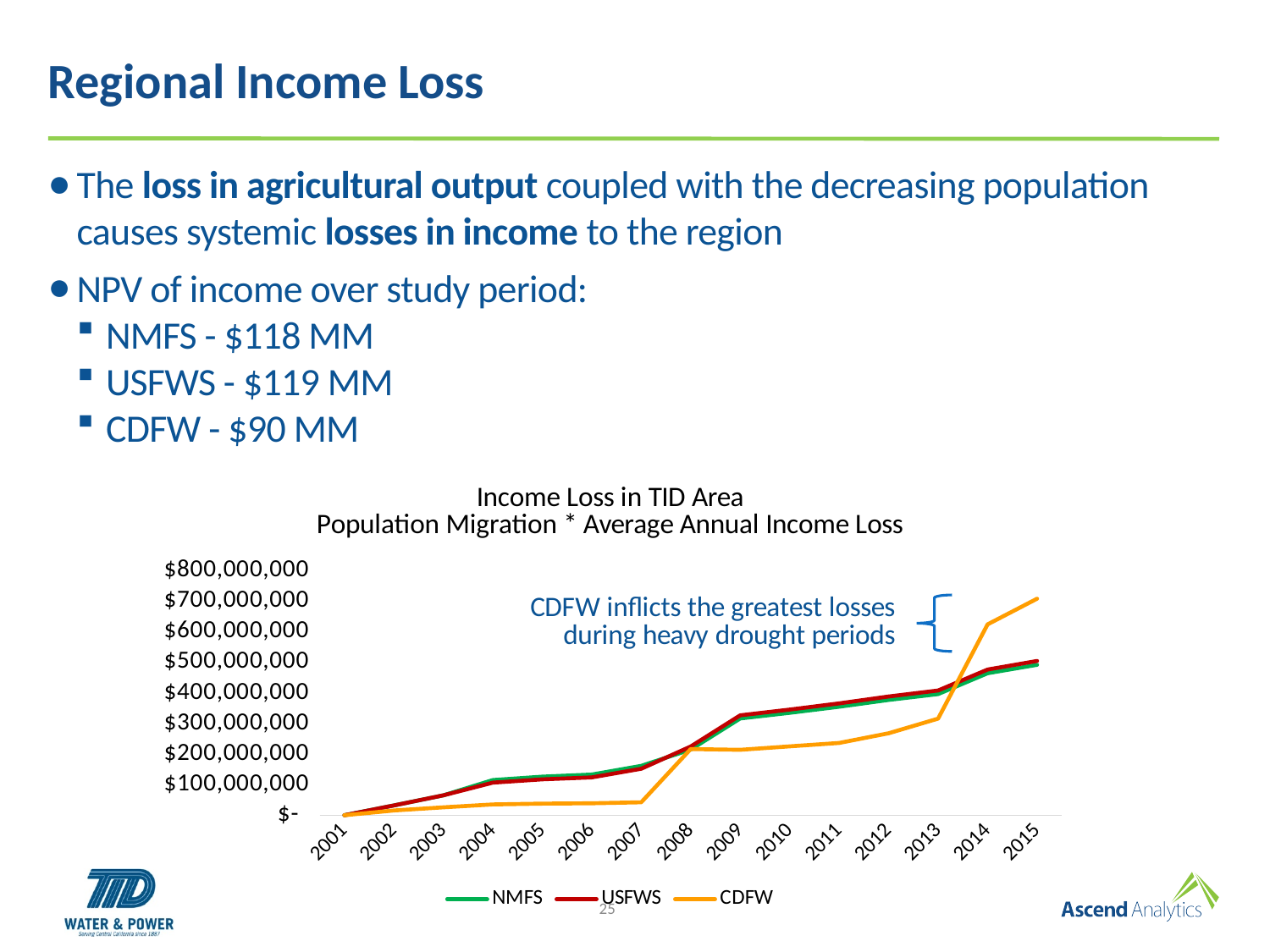
Is the value for CDFW in 2015 greater or less than $600,000,000? greater What is the first line of the chart's title? Income Loss in TID Area Which series has the highest value in 2015? CDFW Which series has the lowest value in 2007? CDFW Is the value for CDFW in 2014 greater or less than $500,000,000? greater In 2007, which is larger: the value for USFWS or the value for CDFW? USFWS Does the CDFW series generally rise or fall from 2001 to 2015? rise How many series does the chart legend list? 3 Is the value for NMFS in 2012 greater or less than $400,000,000? less What kind of chart is shown on the slide? line chart How many years are plotted along the x axis of the chart? 15